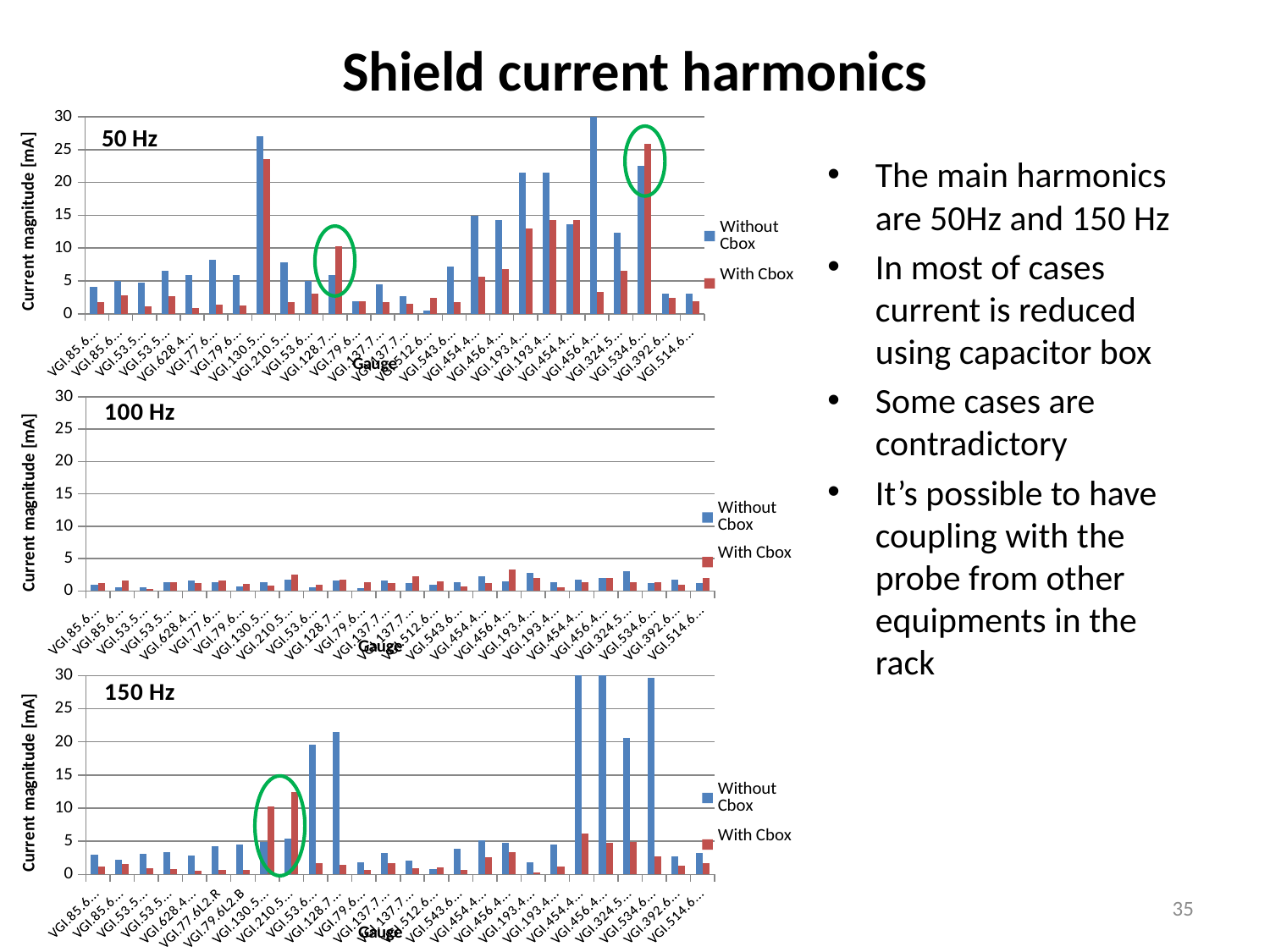
In the 150 Hz chart, for the category VGI.77.6L2.R, which series is larger, Without Cbox or With Cbox? Without Cbox What are the two series named in the legend of the 100 Hz chart? Without Cbox, With Cbox In the 150 Hz chart, is the Without Cbox value for VGI.79.6L2.B greater or less than 10? less In the 100 Hz chart, is the highest value greater or less than 5? less In the 50 Hz chart, which series has the tallest bar overall, Without Cbox or With Cbox? Without Cbox In the 50 Hz chart, is the tallest With Cbox bar greater or less than 20? greater What is the y-axis title of the 50 Hz chart? Current magnitude [mA] What kind of chart is the 50 Hz chart? bar chart How many charts are shown on the slide? 3 How many series does the legend of the 150 Hz chart list? 2